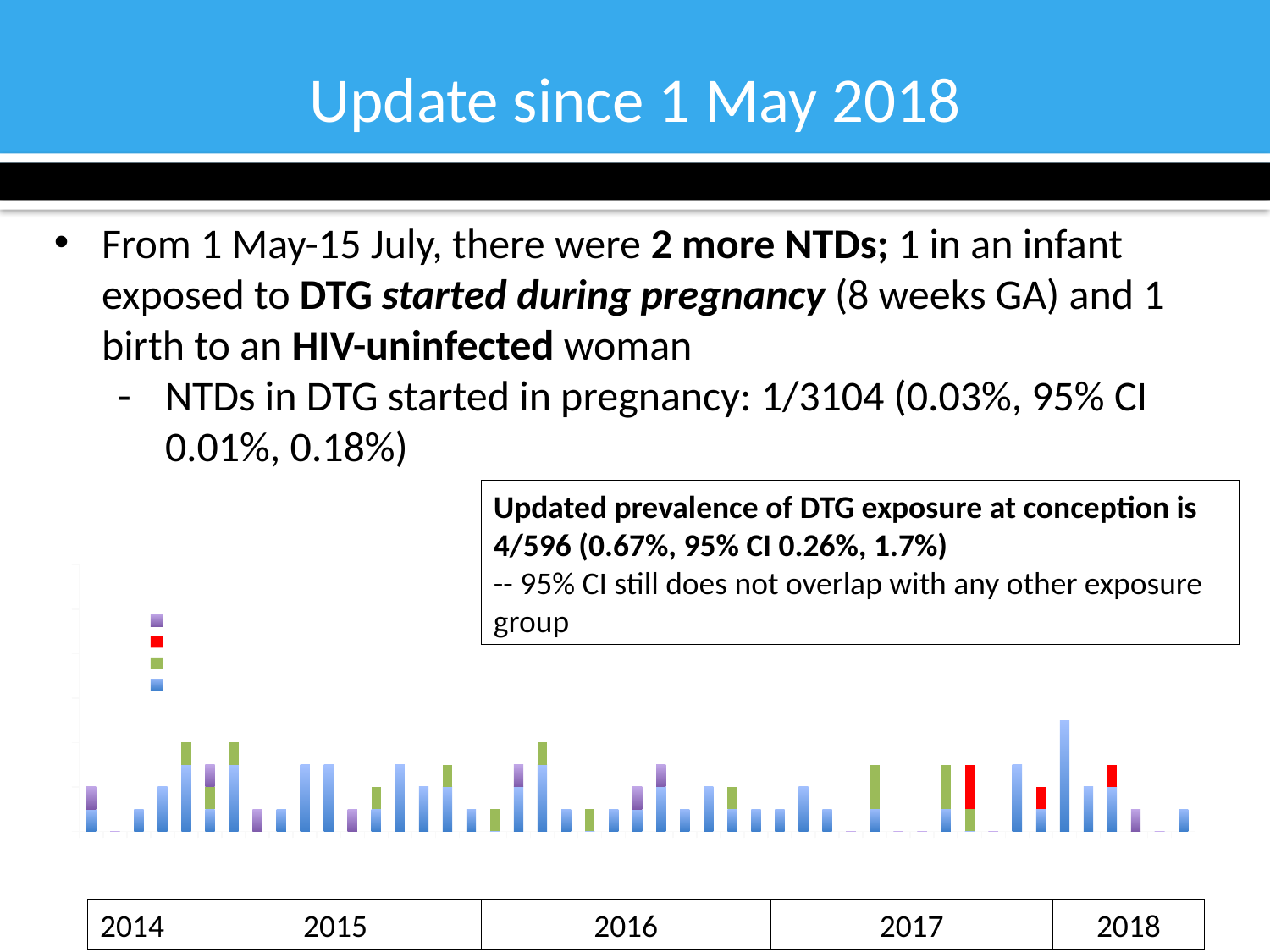
Which year labels appear along the x axis of the chart? 2014, 2015, 2016, 2017, 2018 What kind of chart is shown on the slide? bar chart How many year groups are labelled along the x axis of the chart? 5 What colour is the tallest bar in the chart? blue How many series does the chart's legend list? 4 In which year does the tallest bar of the chart appear? 2018